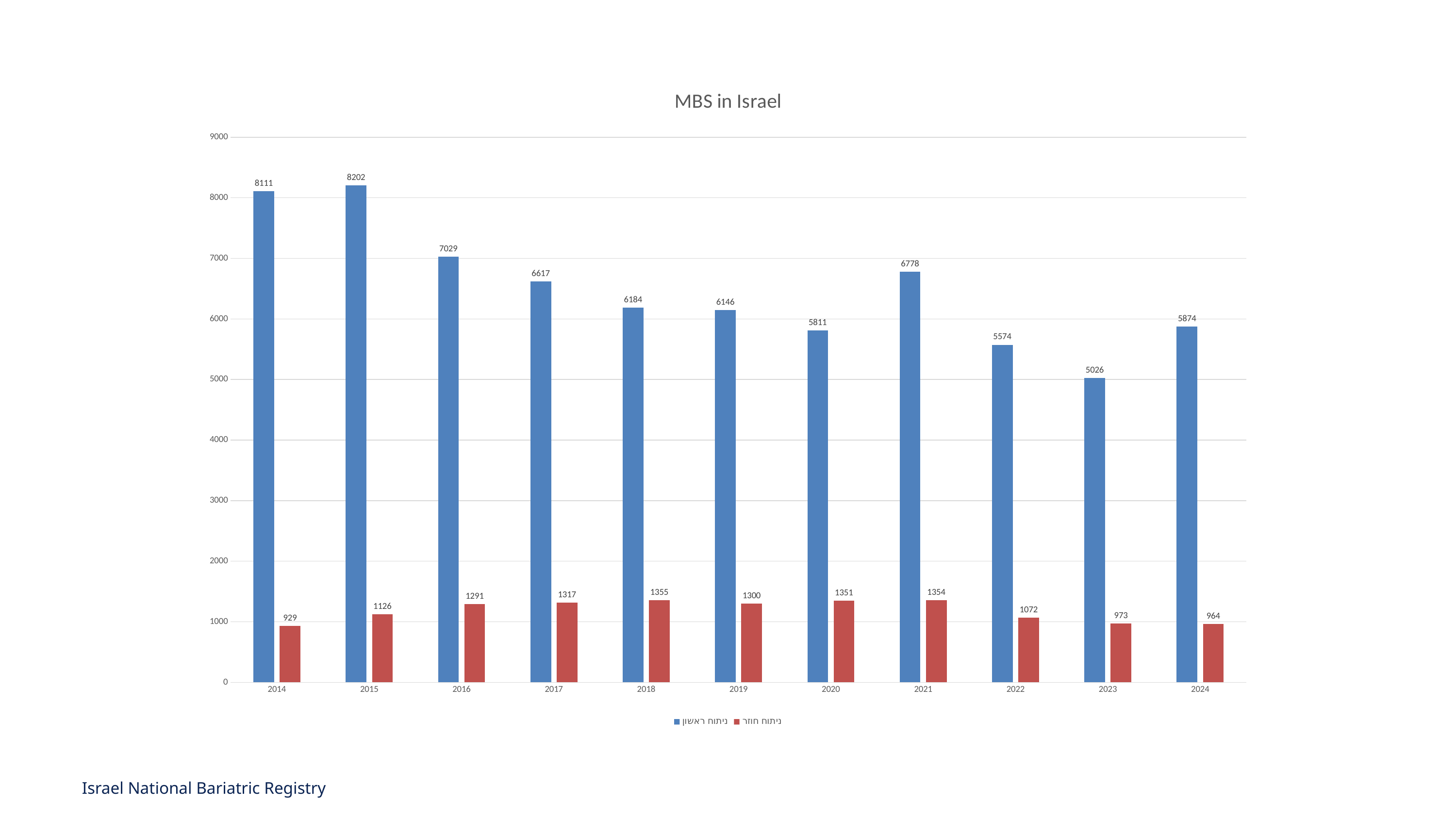
Which year has the lowest value for the blue series (ניתוח ראשון)? 2023 What is the value of the blue series (ניתוח ראשון) for 2015? 8202 What is the title of the chart? MBS in Israel Which year has the highest value for the blue series (ניתוח ראשון)? 2015 How many years are shown on the x axis? 11 Which year has the lowest value for the red series (ניתוח חוזר)? 2014 What is the value of the red series (ניתוח חוזר) for 2018? 1355 What kind of chart is shown on the slide? Bar chart How many series does the legend list? 2 What is the value of the blue series (ניתוח ראשון) for 2024? 5874 What is the difference between the blue series values for 2021 and 2022? 1204 Which is larger: the blue series value for 2019 or for 2020? 2019